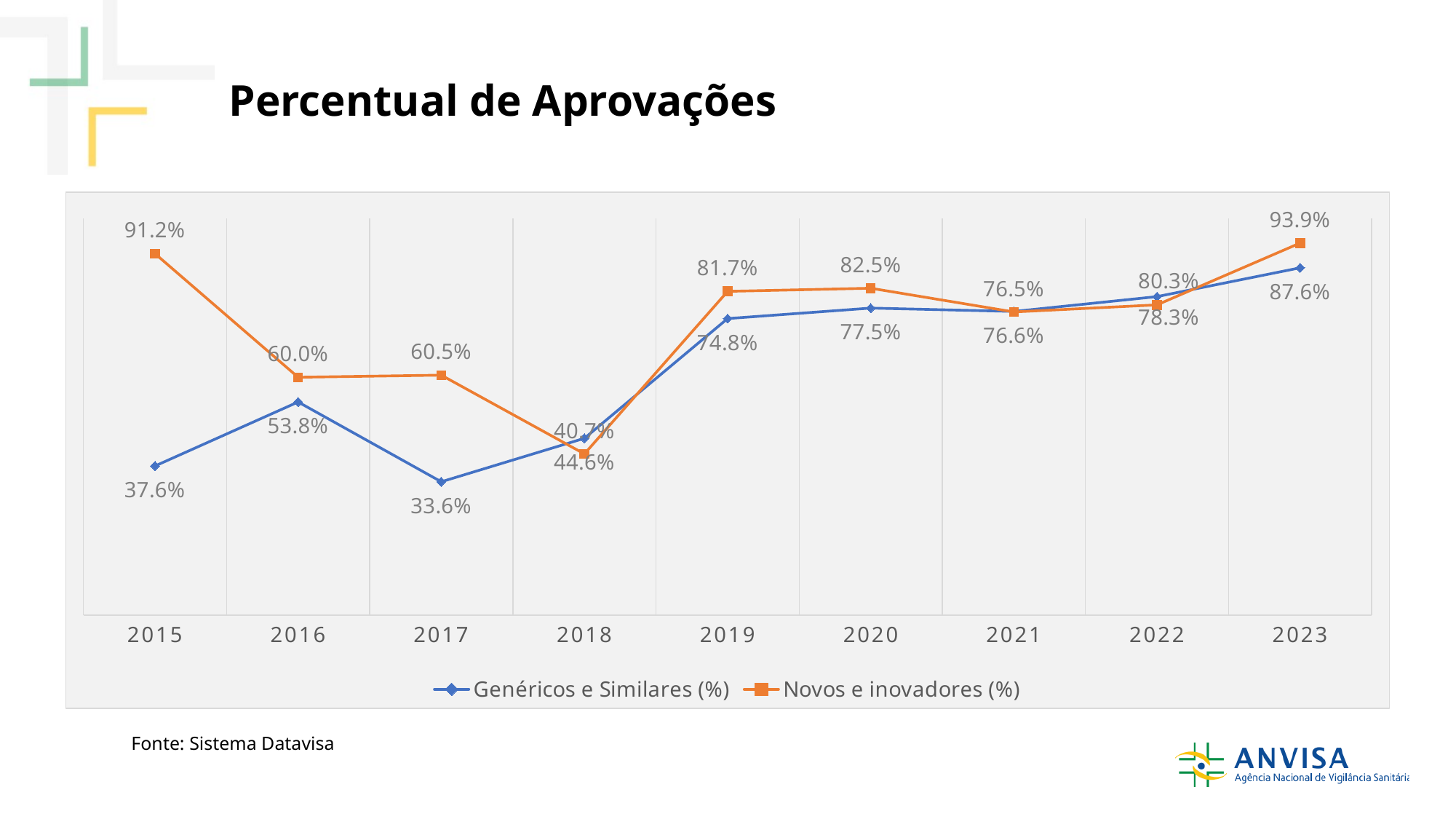
What is the difference between the Novos e inovadores (%) values for 2015 and 2016? 31.2 percentage points What is the value for Novos e inovadores (%) in 2020? 82.5% What is the value for Genéricos e Similares (%) in 2017? 33.6% What is the title of the chart? Percentual de Aprovações In which year does Novos e inovadores (%) reach its highest value? 2023 In which year does Genéricos e Similares (%) have its lowest value? 2017 How many series does the legend list? 2 What is the value for Novos e inovadores (%) in 2015? 91.2% How many years are plotted along the x axis? 9 What is the value for Genéricos e Similares (%) in 2023? 87.6% In 2015, which series has the higher value, Genéricos e Similares (%) or Novos e inovadores (%)? Novos e inovadores (%) What kind of chart is shown on the slide? line chart